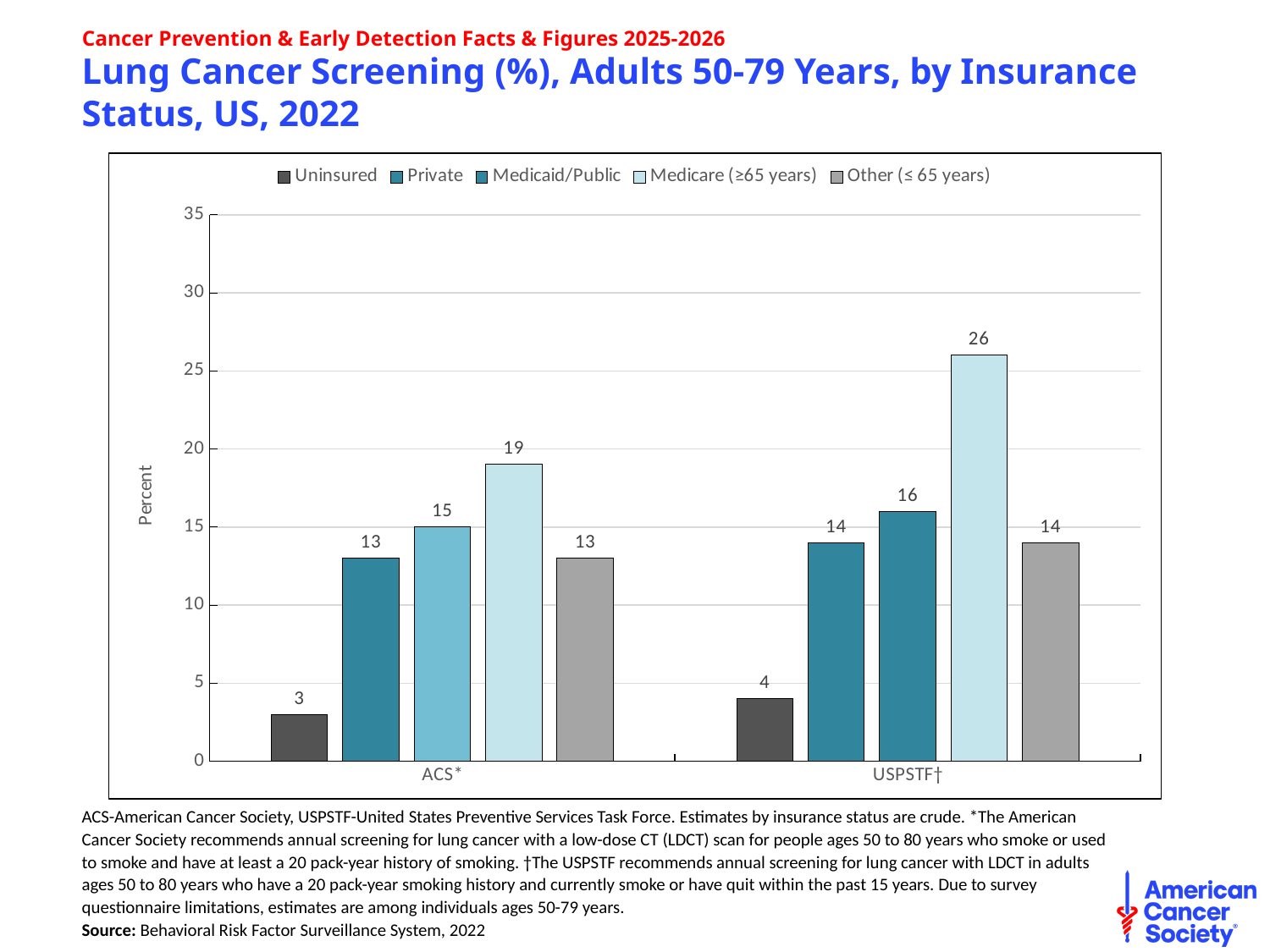
What type of chart is shown on the slide? Bar chart How many series does the legend list? 5 What is the value for Medicaid/Public under the ACS* criteria? 15 What is the label of the y axis? Percent What is the value for Medicare (≥65 years) under the USPSTF† criteria? 26 Which is larger: the Private value under ACS* or the Private value under USPSTF†? USPSTF† What is the difference between the Medicare (≥65 years) values for USPSTF† and ACS*? 7 What is the lung cancer screening percentage for Uninsured adults under the ACS* criteria? 3 Which insurance group has the highest screening percentage under the USPSTF† criteria? Medicare (≥65 years) What is the value for Other (≤ 65 years) under the USPSTF† criteria? 14 How many categories are shown on the x axis? 2 Which insurance group has the lowest screening percentage under the ACS* criteria? Uninsured